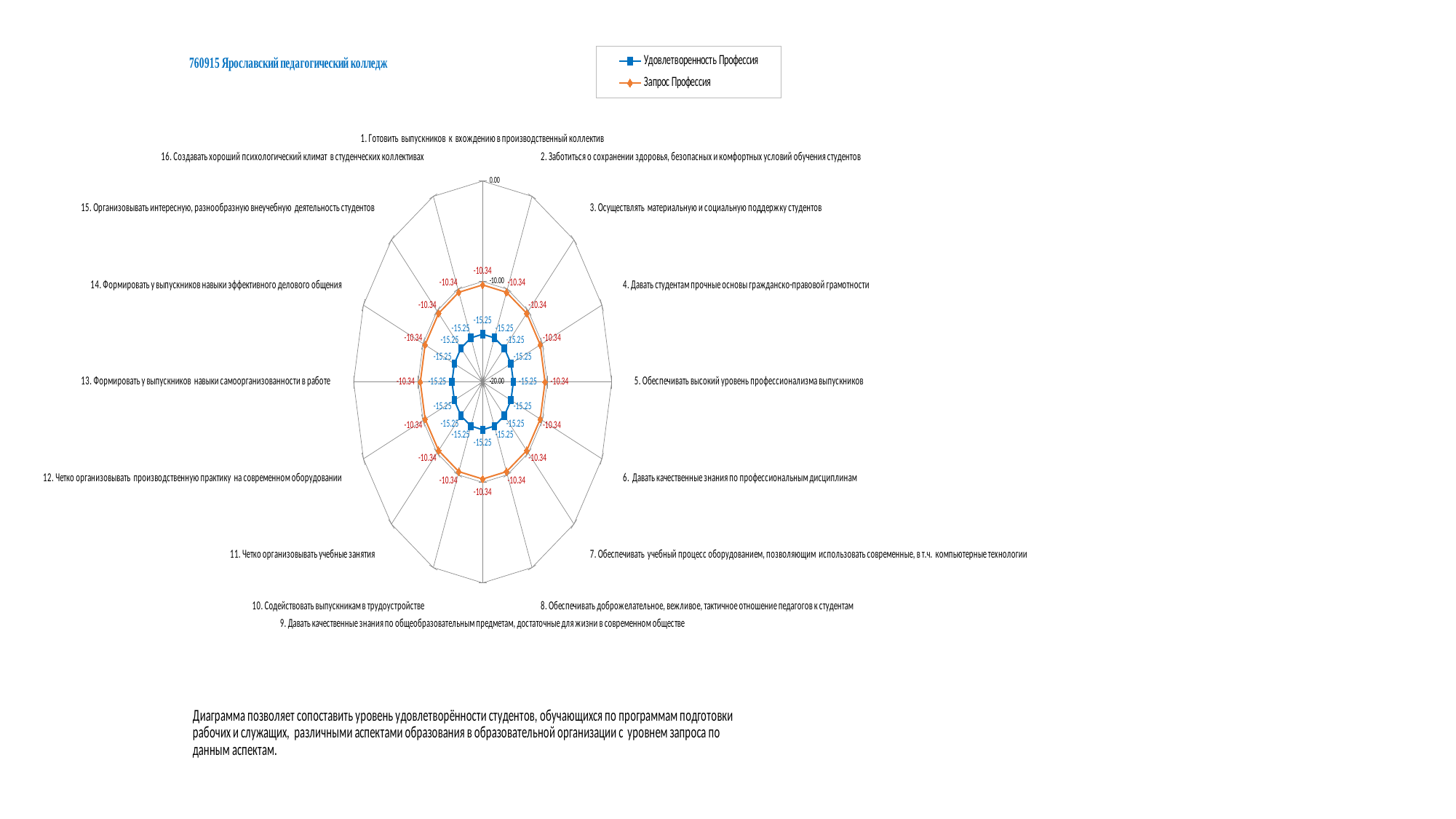
What is the title shown above the chart? 760915 Ярославский педагогический колледж What is the value of the 'Удовлетворенность Профессия' series for category '5. Обеспечивать высокий уровень профессионализма выпускников'? -15.25 What kind of chart is shown on the slide? Radar chart Which series has the larger value for category '3. Осуществлять материальную и социальную поддержку студентов'? Запрос Профессия Which series is drawn with orange diamond markers? Запрос Профессия What is the value of the 'Удовлетворенность Профессия' series for category '13. Формировать у выпускников навыки самоорганизованности в работе'? -15.25 What is the value of the 'Запрос Профессия' series for category '9. Давать качественные знания по общеобразовательным предметам, достаточные для жизни в современном обществе'? -10.34 What is the value of the 'Запрос Профессия' series for category '1. Готовить выпускников к вхождению в производственный коллектив'? -10.34 How many categories (axes) does the radar chart have? 16 Is the value of 'Удовлетворенность Профессия' for category '11. Четко организовывать учебные занятия' greater or less than -10.00? less How many series does the legend list? 2 What is the difference between the 'Запрос Профессия' and 'Удовлетворенность Профессия' values for category '7. Обеспечивать учебный процесс оборудованием, позволяющим использовать современные, в т.ч. компьютерные технологии'? 4.91